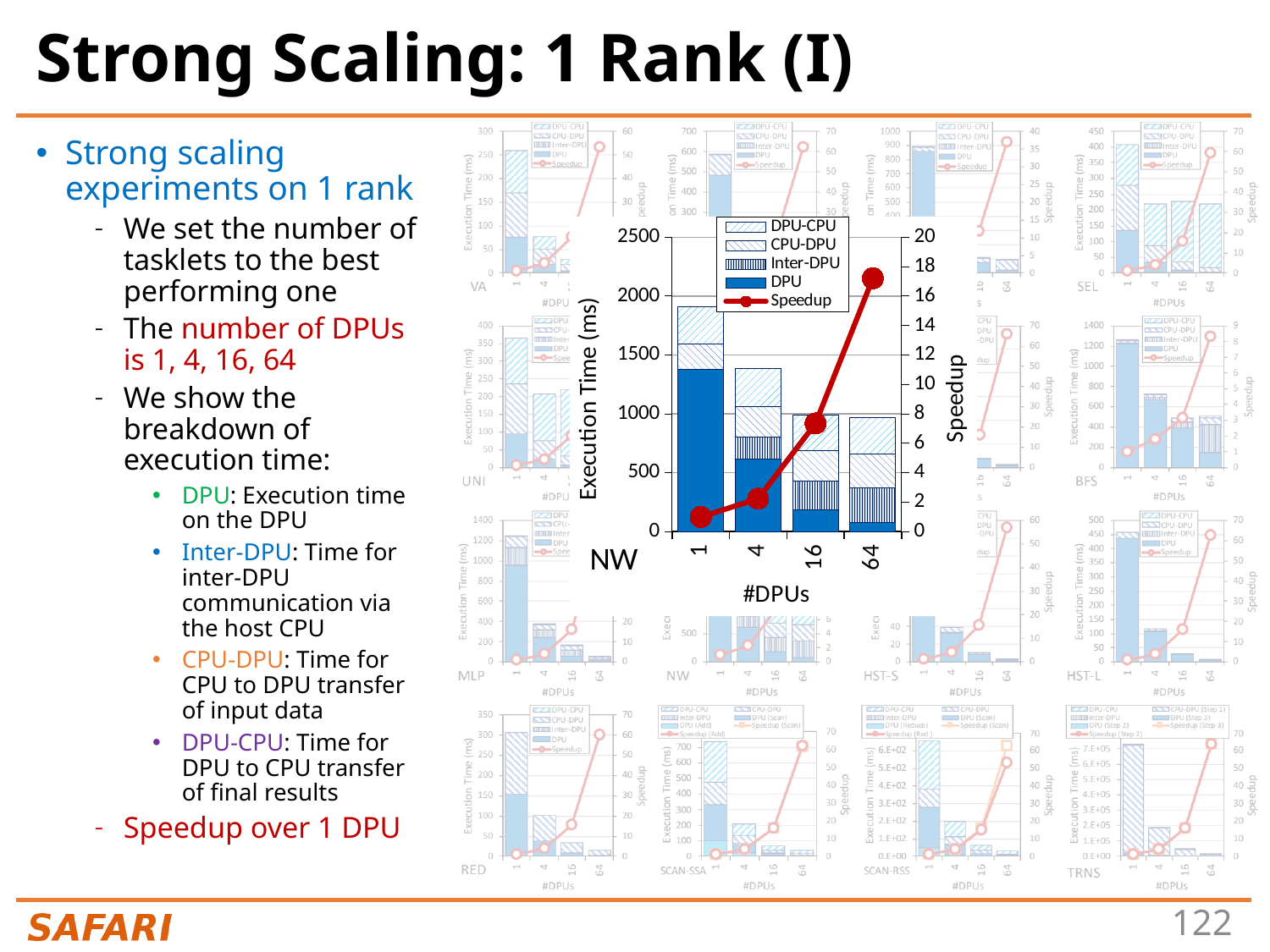
In the large NW chart, which #DPUs value has the lowest speedup? 1 In the large NW chart, is the speedup for 64 DPUs greater or less than 14? greater In the large NW chart, which has the larger DPU (solid blue) execution time: 1 DPU or 4 DPUs? 1 DPU What kind of chart is the large NW chart? Stacked bar chart with a line In the large NW chart, how many #DPUs categories are shown on the x axis? 4 In the large NW chart, which #DPUs value has the highest total execution time? 1 In the large NW chart, is the speedup for 16 DPUs greater or less than 6? greater In the large NW chart, how many series does the legend list? 5 In the large NW chart, is the total execution time for 1 DPU greater or less than 1500 ms? greater What is the label of the right-hand y axis of the large NW chart? Speedup In the large NW chart, does the speedup rise or fall as #DPUs increases? rises In the large NW chart, which #DPUs value has the highest speedup? 64